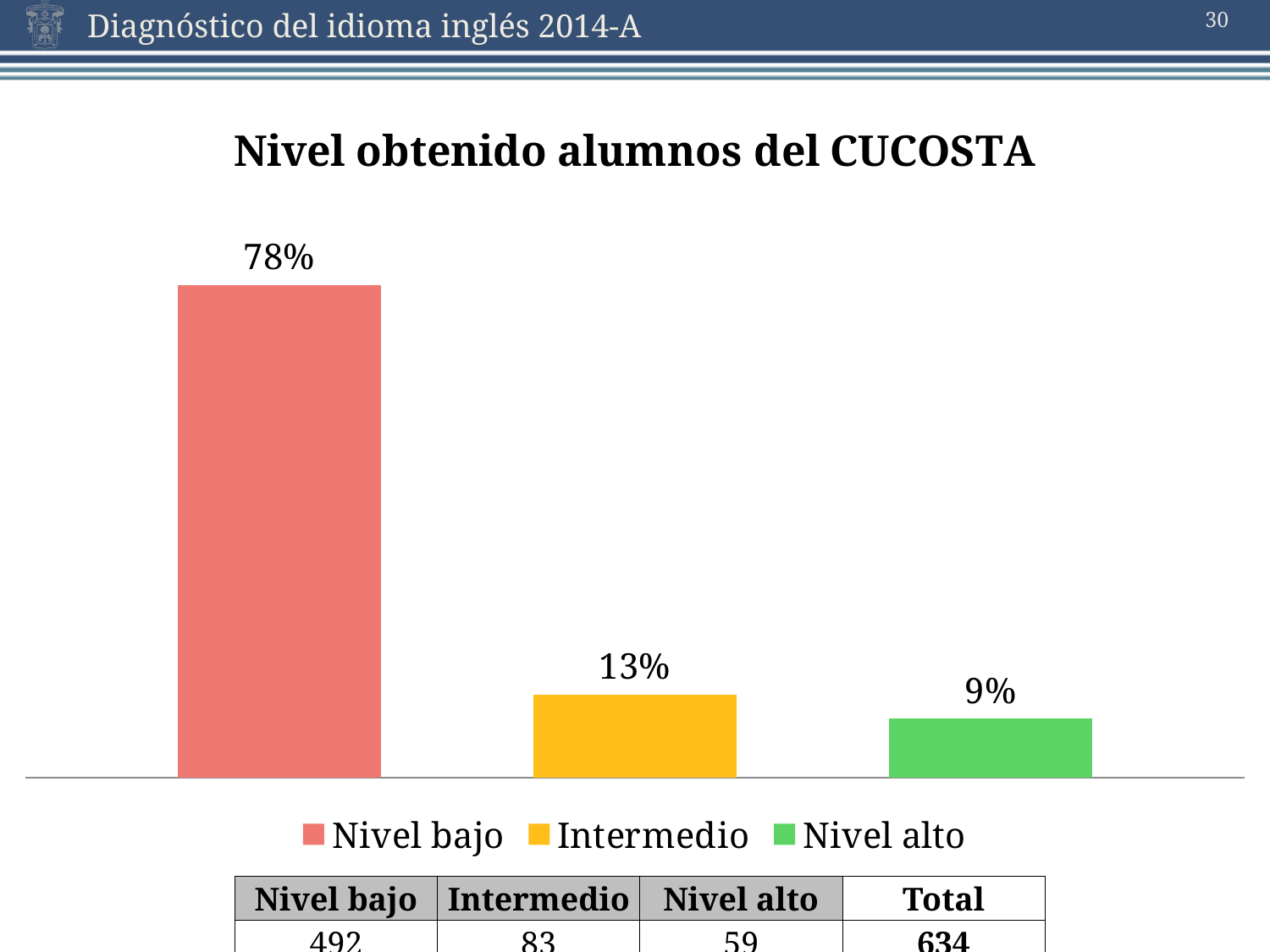
What is the difference between the values for Intermedio and Nivel alto? 4% What is the value for Nivel alto? 9% What kind of chart is shown on the slide? Bar chart What is the difference between the values for Nivel bajo and Intermedio? 65% How many bars are shown in the chart? 3 Which category has the lowest value? Nivel alto Which is larger, the value for Intermedio or the value for Nivel alto? Intermedio How many entries does the legend list? 3 What is the title of the chart? Nivel obtenido alumnos del CUCOSTA What is the value for Intermedio? 13% What is the value for Nivel bajo? 78% Which category has the highest value? Nivel bajo